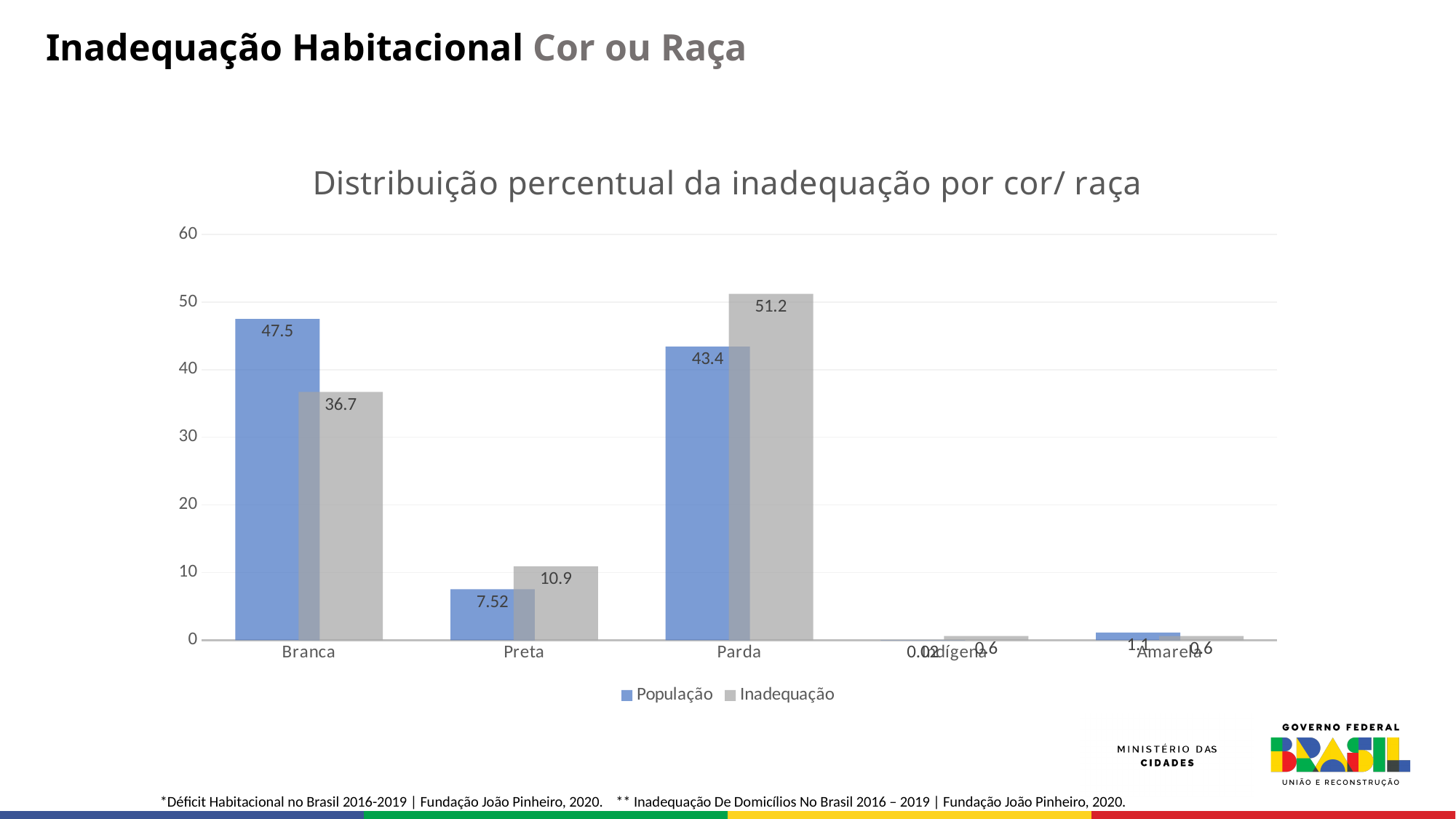
How many categories are shown on the x axis? 5 What is the Inadequação value for Preta? 10.9 What is the difference between the Inadequação and População values for Parda? 7.8 What kind of chart is shown on the slide? Bar chart Which category has the highest Inadequação value? Parda What is the difference between the População and Inadequação values for Branca? 10.8 Which category has the highest População value? Branca For Preta, which is larger: População or Inadequação? Inadequação How many series does the legend list? 2 What is the População value for Preta? 7.52 What is the Inadequação value for Parda? 51.2 What is the População value for Branca? 47.5